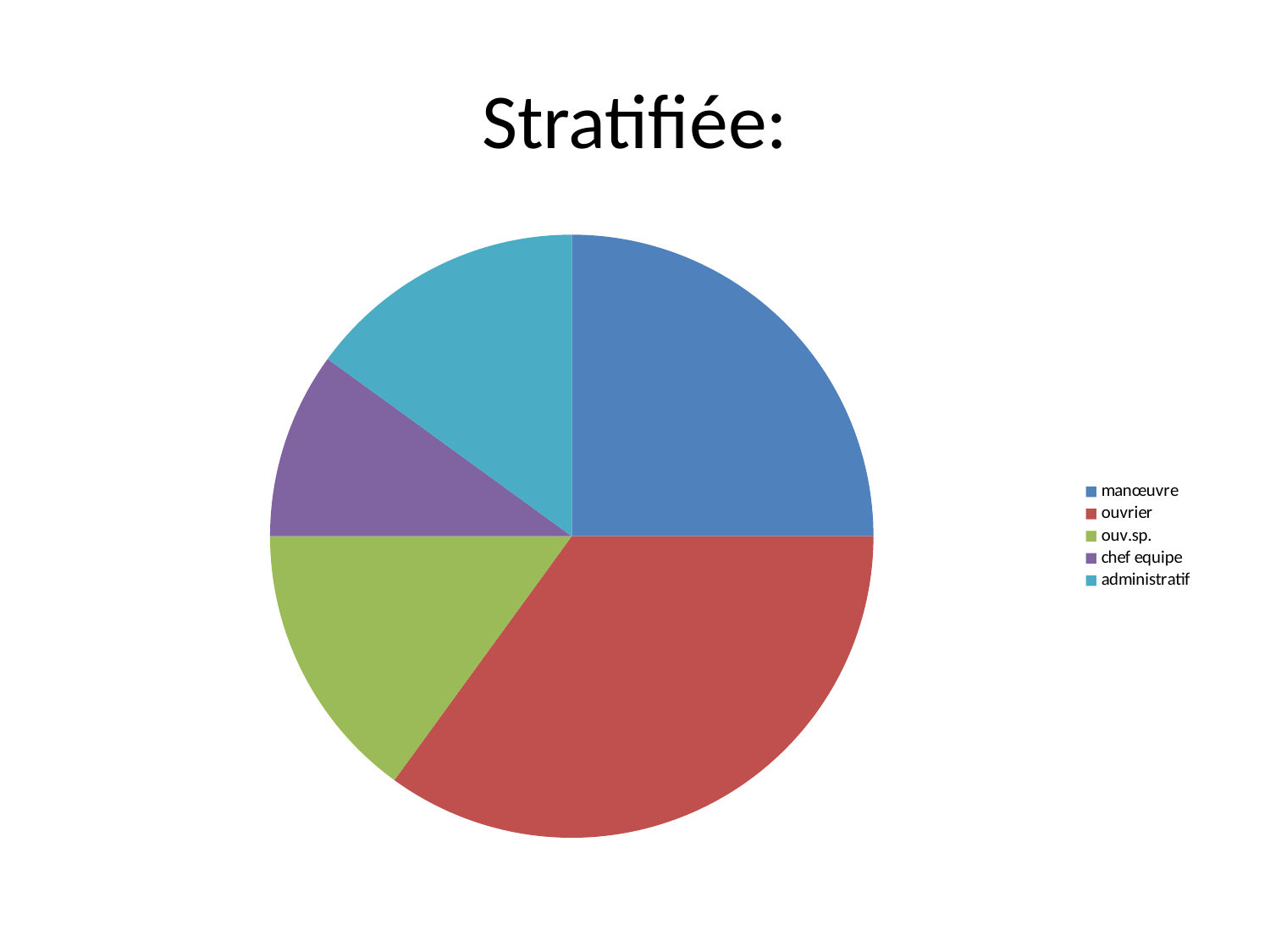
Which slice is larger, administratif or chef equipe? administratif Which slice is larger, manœuvre or chef equipe? manœuvre Which category has the largest slice of the pie? ouvrier Which category is shown in red in the pie chart? ouvrier How many categories does the pie chart show? 5 Which slice is larger, ouvrier or manœuvre? ouvrier What is the title of the slide? Stratifiée: What kind of chart is shown on the slide? pie chart Which category has the smallest slice of the pie? chef equipe